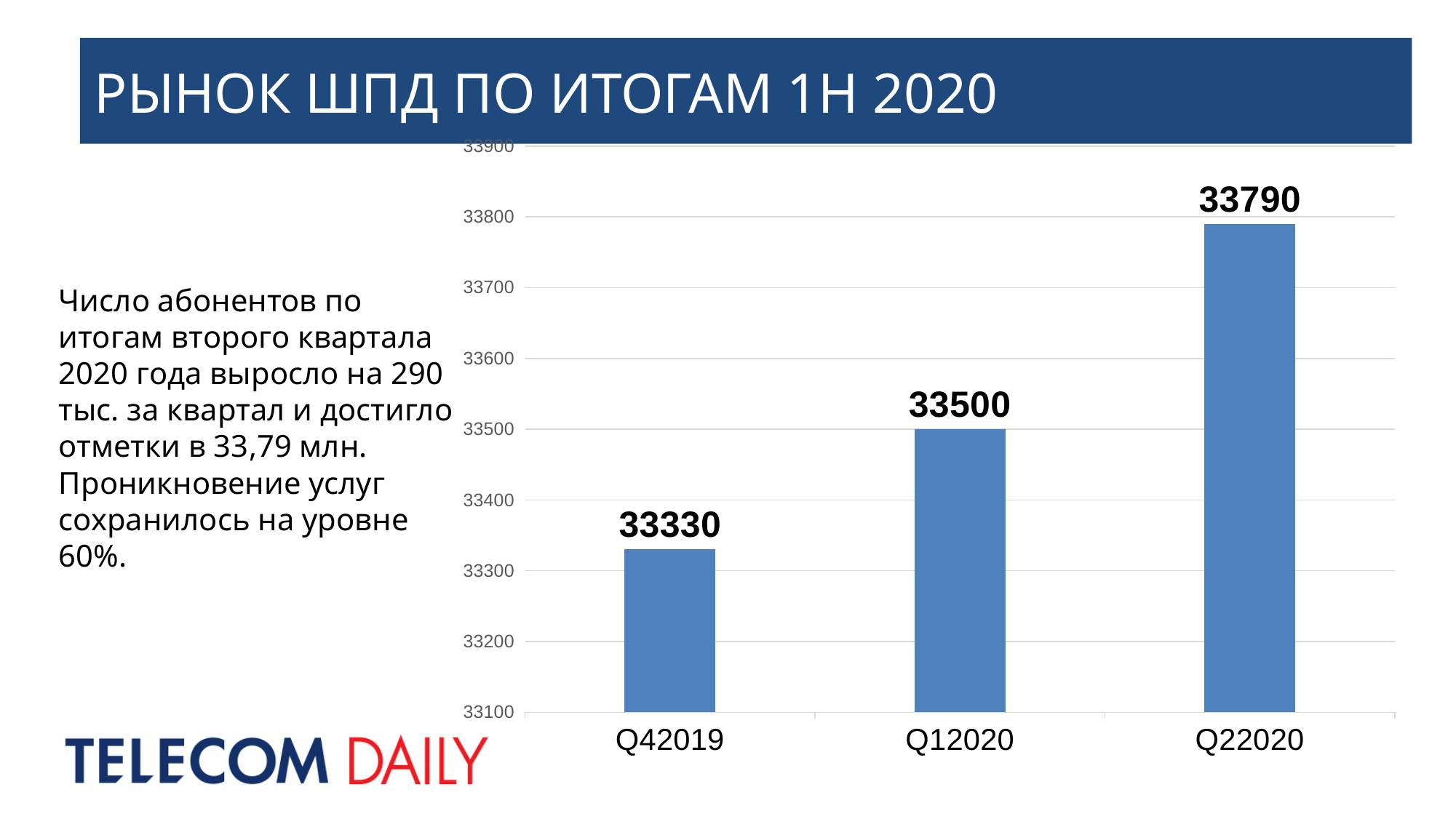
Which is larger, the value for Q12020 or the value for Q42019? Q12020 What is the difference between the values for Q22020 and Q12020? 290 How many quarters are shown on the chart? 3 What is the value for Q22020? 33790 What kind of chart is shown on the slide? bar chart Which quarter has the lowest value? Q42019 Which quarter has the highest value? Q22020 Do the values rise or fall from Q42019 to Q22020? rise What is the value for Q42019? 33330 Is the value for Q22020 greater or less than 33700? greater What is the difference between the values for Q12020 and Q42019? 170 What is the value for Q12020? 33500